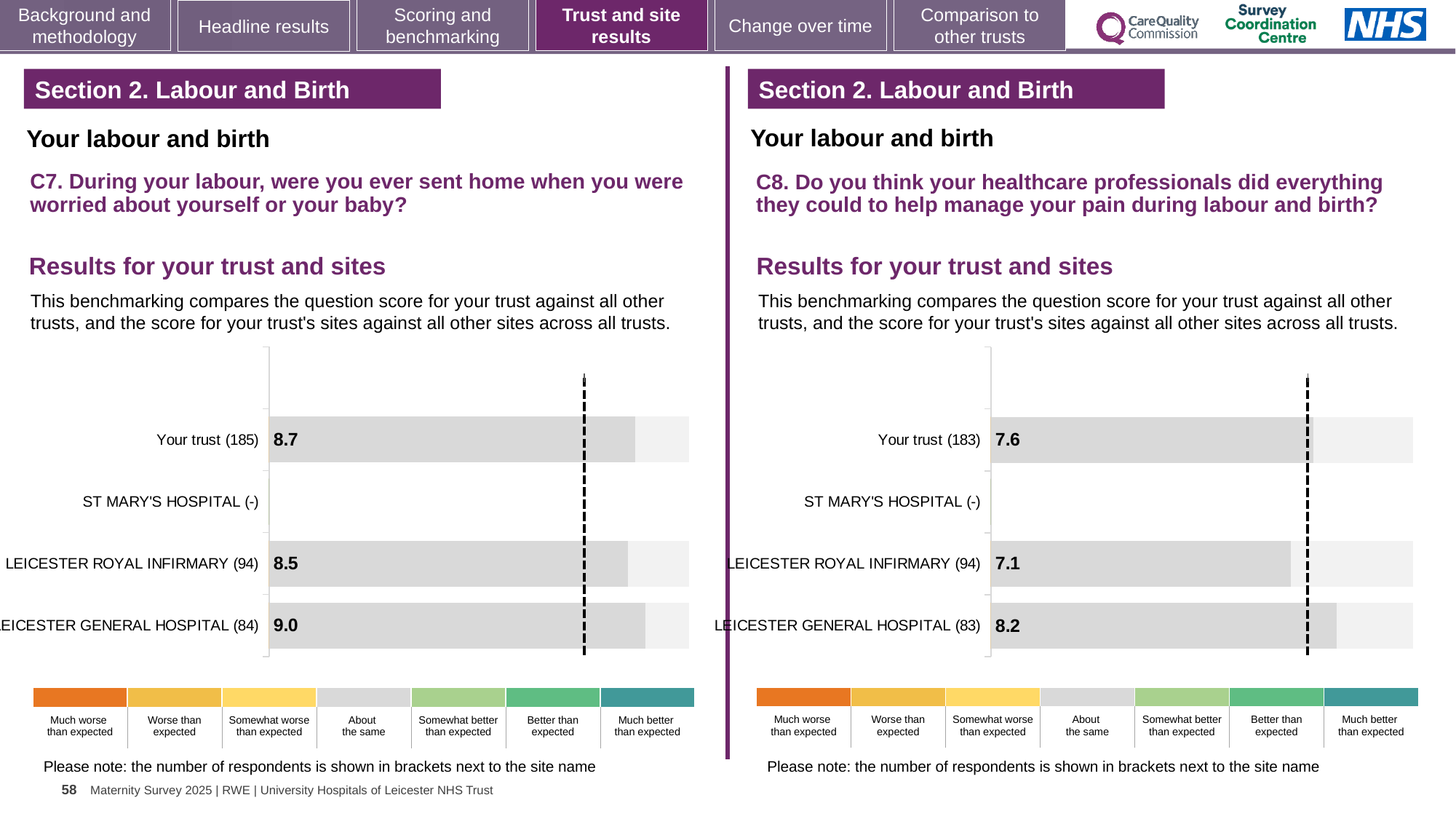
In the C8 chart on the right, which site has no score shown? St Mary's Hospital What type of chart is used on the left for C7? Bar chart In the C8 chart on the right, what is the score for Leicester Royal Infirmary? 7.1 In the C8 chart on the right, which has the higher score: Your trust or Leicester General Hospital? Leicester General Hospital In the C7 chart on the left, how many respondents are shown in brackets for Leicester Royal Infirmary? 94 In the C7 chart on the left, what is the score for Your trust? 8.7 In the C7 chart on the left, which site has the highest score? Leicester General Hospital In the C7 chart on the left, what is the difference between the scores for Leicester General Hospital and Leicester Royal Infirmary? 0.5 In the C8 chart on the right, what is the score for Your trust? 7.6 In the C7 chart on the left, what is the score for Leicester General Hospital? 9.0 In the C8 chart on the right, which site has the lowest score? Leicester Royal Infirmary In the C8 chart on the right, what is the difference between the scores for Leicester General Hospital and Your trust? 0.6